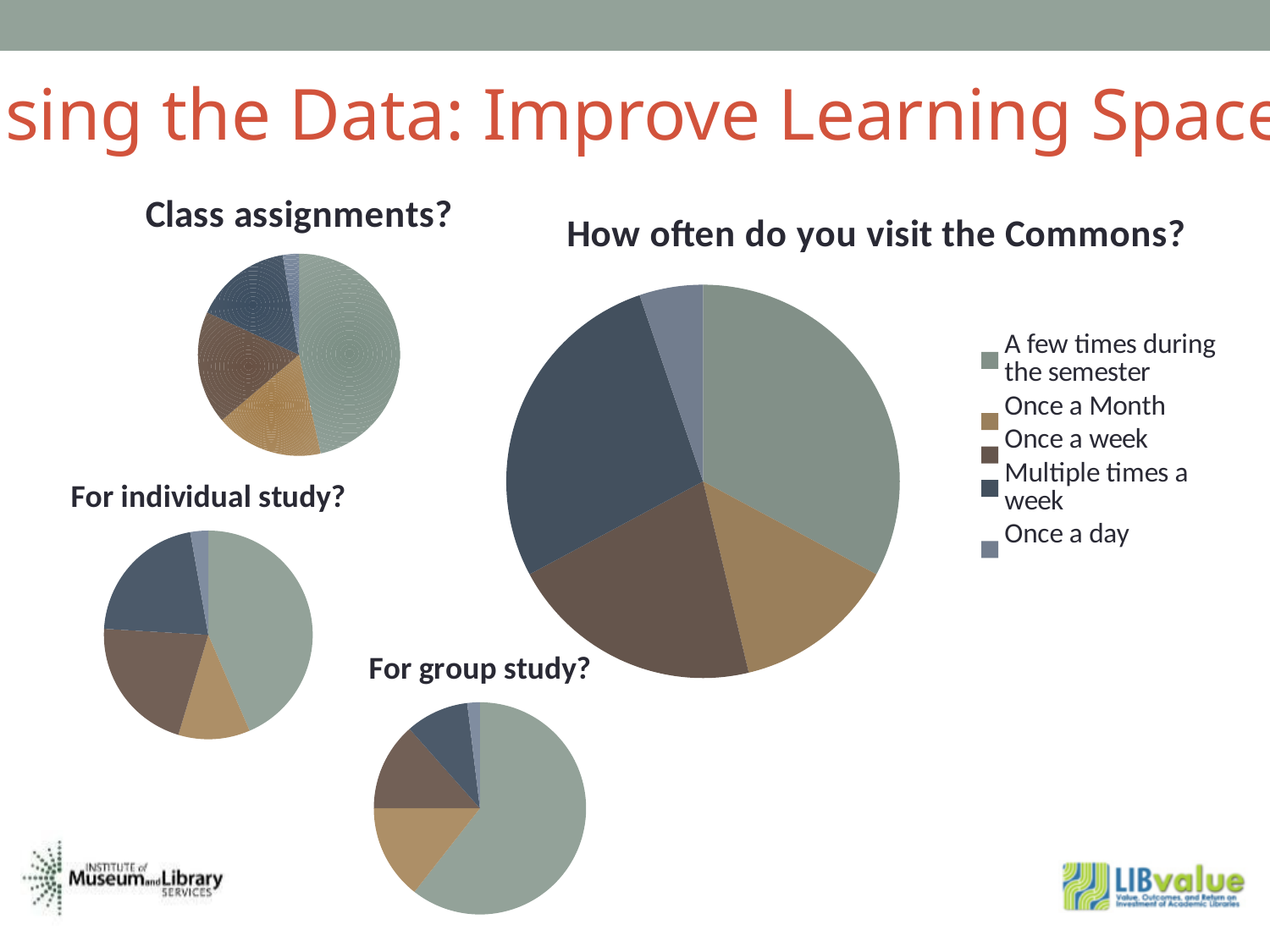
In the "How often do you visit the Commons?" chart, which category has the smallest slice? Once a day In the "For group study?" chart, which category has the largest slice? A few times during the semester What kind of chart is "How often do you visit the Commons?"? pie chart In the "Class assignments?" chart, which category has the smallest slice? Once a day In the "How often do you visit the Commons?" chart, which is larger: Once a Month or Once a day? Once a Month In the "For individual study?" chart, which category has the largest slice? A few times during the semester How many entries does the legend list? 5 In the "For group study?" chart, which category has the smallest slice? Once a day In the "For individual study?" chart, which is larger: Once a week or Once a Month? Once a week How many pie charts are shown on the slide? 4 How many slices does the "For group study?" pie chart have? 5 In the "Class assignments?" chart, which category has the largest slice? A few times during the semester